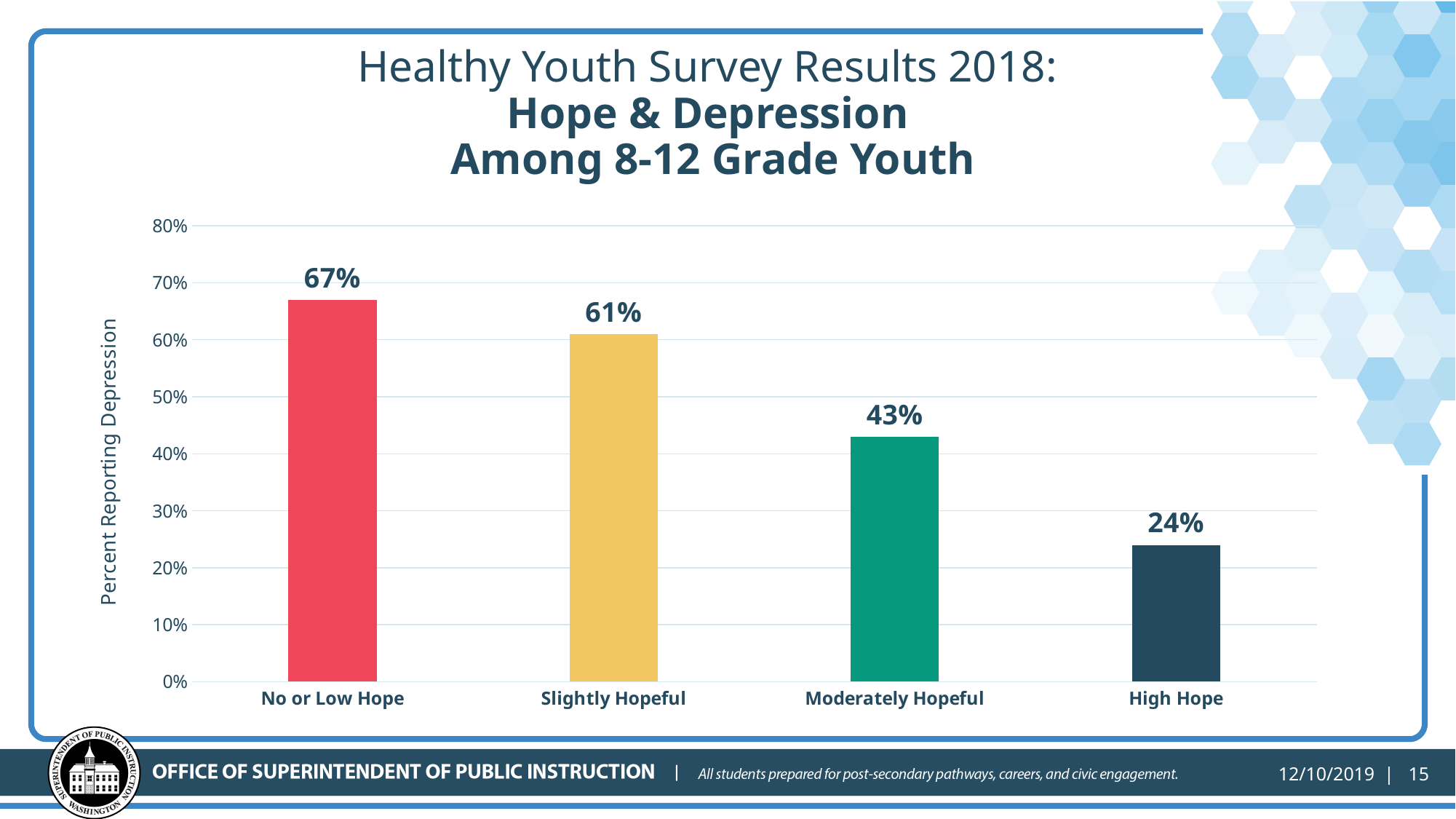
What kind of chart is shown on the slide? Bar chart Do the values rise or fall moving from No or Low Hope to High Hope along the x axis? Fall Which is larger, the value for Moderately Hopeful or the value for High Hope? Moderately Hopeful What is the value for Moderately Hopeful? 43% Which hope category has the lowest percent reporting depression? High Hope What percent of youth with No or Low Hope report depression? 67% How many hope categories are shown on the chart? 4 What is the value for Slightly Hopeful? 61% Which hope category has the highest percent reporting depression? No or Low Hope What is the difference between the Slightly Hopeful and Moderately Hopeful values? 18% What percent of youth with High Hope report depression? 24% What is the difference in percent reporting depression between No or Low Hope and High Hope? 43%